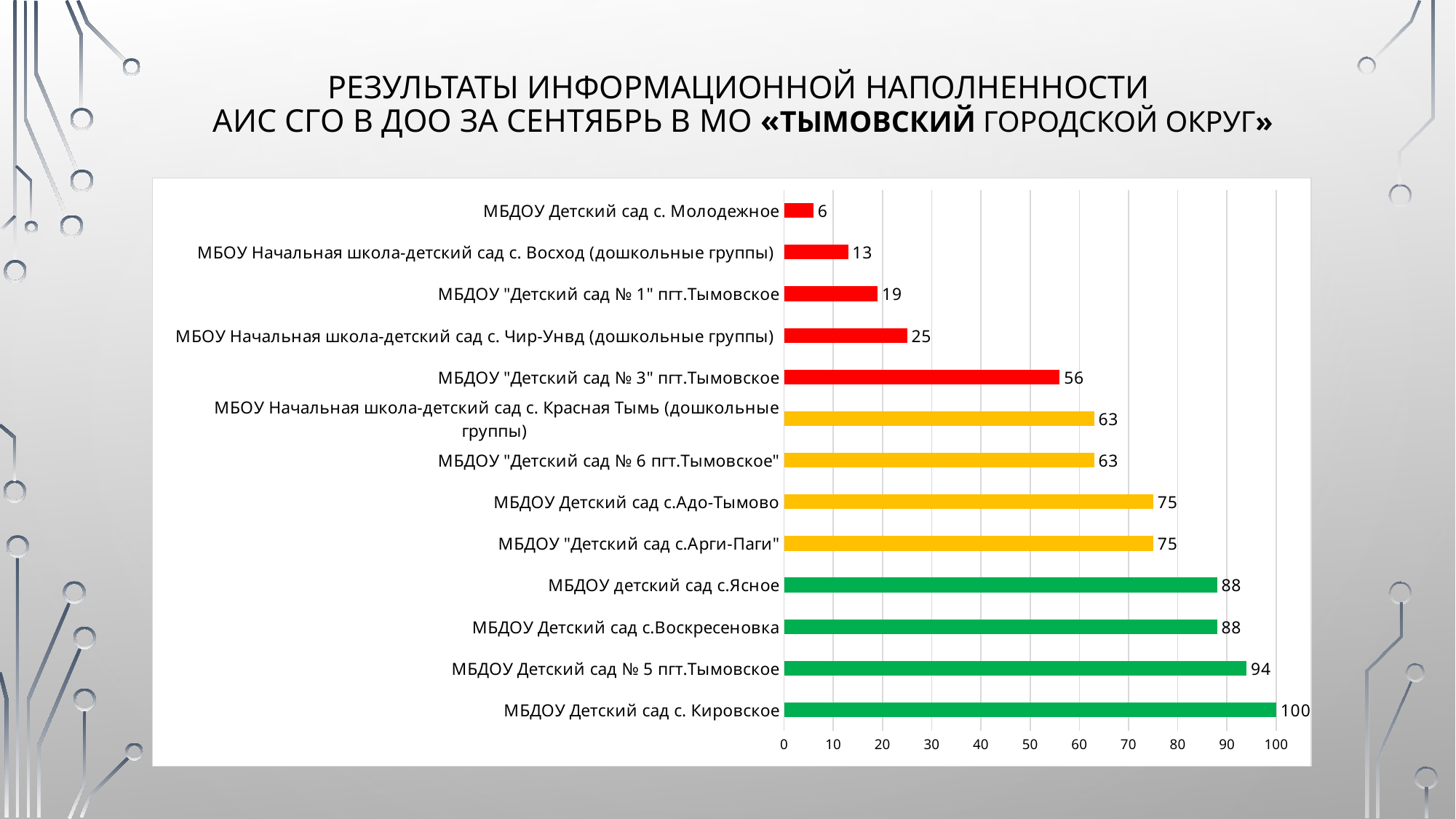
Which category has the lowest value? МБДОУ Детский сад с. Молодежное What kind of chart is shown on the slide? bar chart What is the value for МБОУ Начальная школа-детский сад с. Восход (дошкольные группы)? 13 What colour are the bars with the highest values (88 and above)? green Which category has the highest value? МБДОУ Детский сад с. Кировское What is the difference between the values for МБДОУ Детский сад № 5 пгт.Тымовское and МБДОУ Детский сад с.Ясное? 6 What is the difference between the values for МБДОУ Детский сад с. Кировское and МБДОУ Детский сад с. Молодежное? 94 Is the value for МБОУ Начальная школа-детский сад с. Чир-Унвд (дошкольные группы) greater or less than 30? less Which is larger: the value for МБДОУ Детский сад с.Адо-Тымово or the value for МБДОУ "Детский сад № 1" пгт.Тымовское? МБДОУ Детский сад с.Адо-Тымово What is the value for МБДОУ "Детский сад № 3" пгт.Тымовское? 56 What is the value for МБДОУ Детский сад с. Кировское? 100 How many categories are shown in the chart? 13